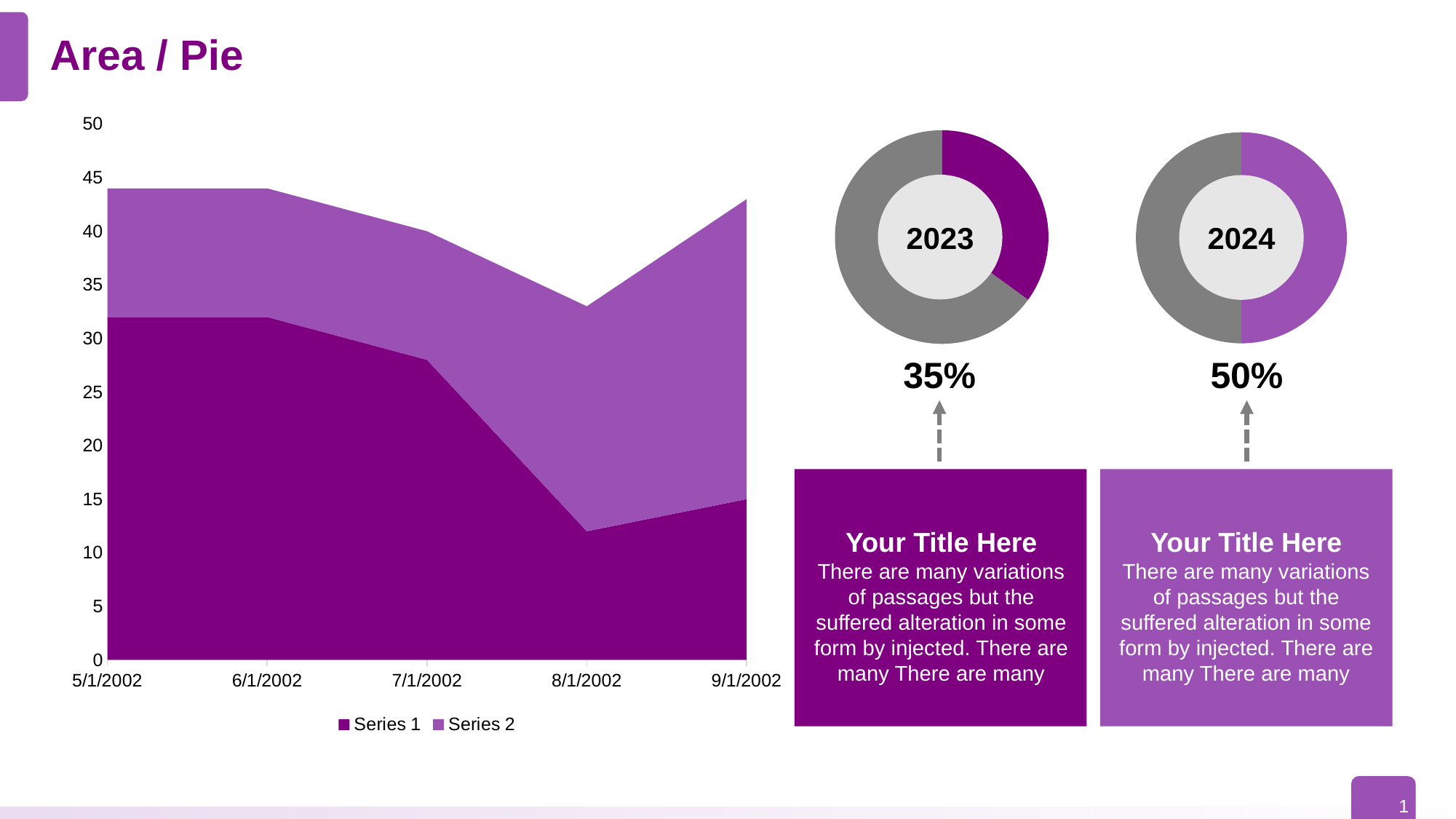
What is the difference between the percentages shown for the 2024 and 2023 donut charts? 15% In the area chart, is the value for Series 1 at 5/1/2002 greater or less than 30? greater In the area chart, at which date is the stacked total of both series lowest? 8/1/2002 How many series does the legend of the area chart list? 2 Which donut chart shows the larger percentage, 2023 or 2024? 2024 What percentage is shown below the 2023 donut chart? 35% In the area chart, does Series 1 rise or fall from 5/1/2002 to 8/1/2002? fall How many dates are shown on the x axis of the area chart? 5 In the area chart, is the value for Series 1 at 8/1/2002 greater or less than 15? less What kind of chart is shown on the left side of the slide? area chart In the area chart, is the stacked total at 9/1/2002 greater or less than 40? greater In the area chart, at which date is Series 1 lowest? 8/1/2002